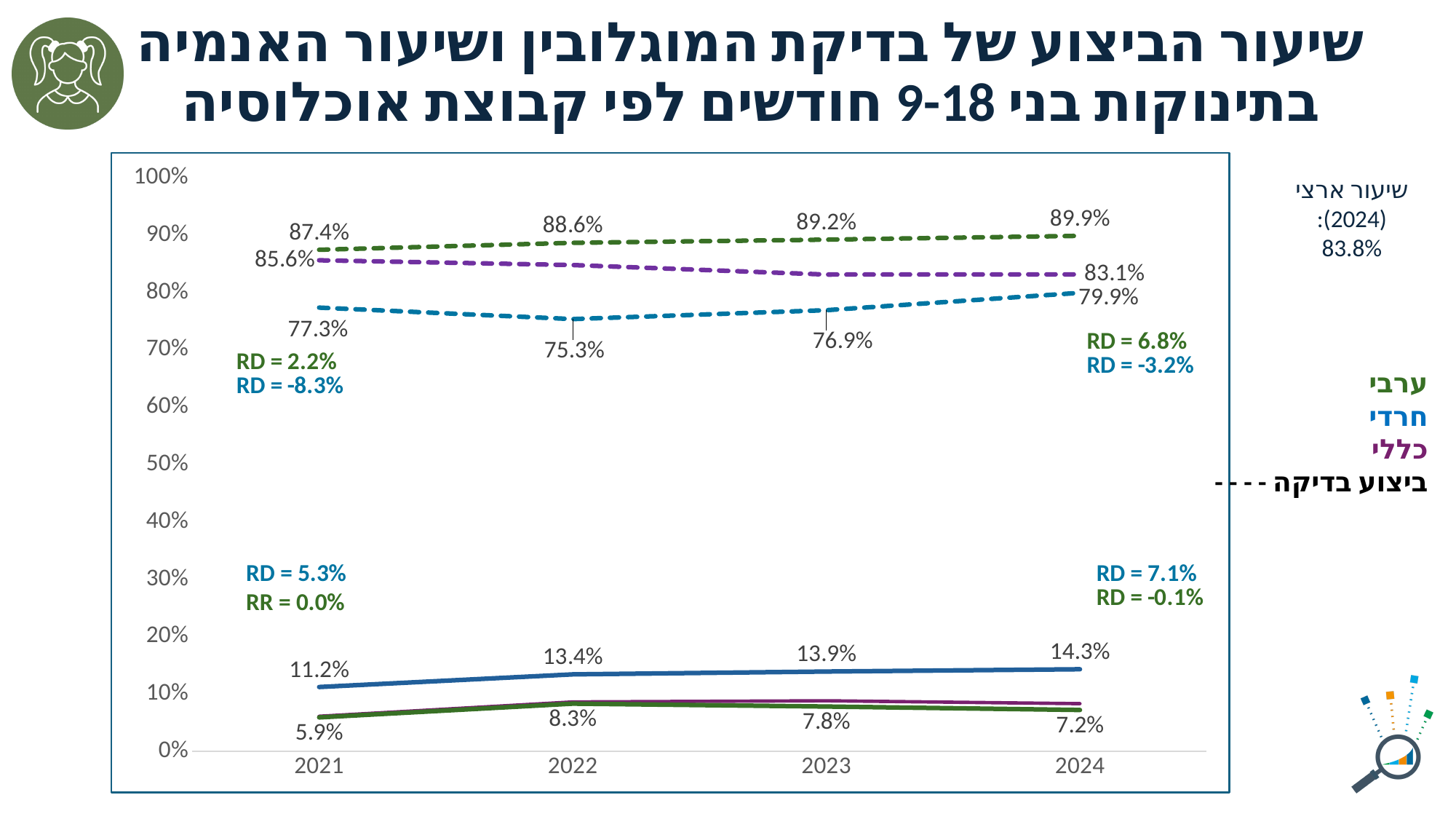
What is the difference between the ערבי (Arab) and חרדי (Haredi) test performance rates in 2021? 10.1% What is the anemia rate (solid line) for the חרדי (Haredi) group in 2021? 11.2% How many years are shown on the x axis? 4 What is the national rate (שיעור ארצי) for 2024 shown on the slide? 83.8% What is the test performance rate (dashed line) for the חרדי (Haredi) group in 2022? 75.3% What is the test performance rate (dashed line) for the ערבי (Arab) group in 2024? 89.9% What kind of chart is shown on the slide? line chart What is the test performance rate (dashed line) for the כללי (General) group in 2024? 83.1% What is the anemia rate (solid line) for the ערבי (Arab) group in 2023? 7.8% Does the test performance rate for the ערבי (Arab) group rise or fall from 2021 to 2024? rise Which group has the highest test performance rate (dashed line) in 2024? ערבי Which group has the lowest test performance rate (dashed line) in 2021? חרדי